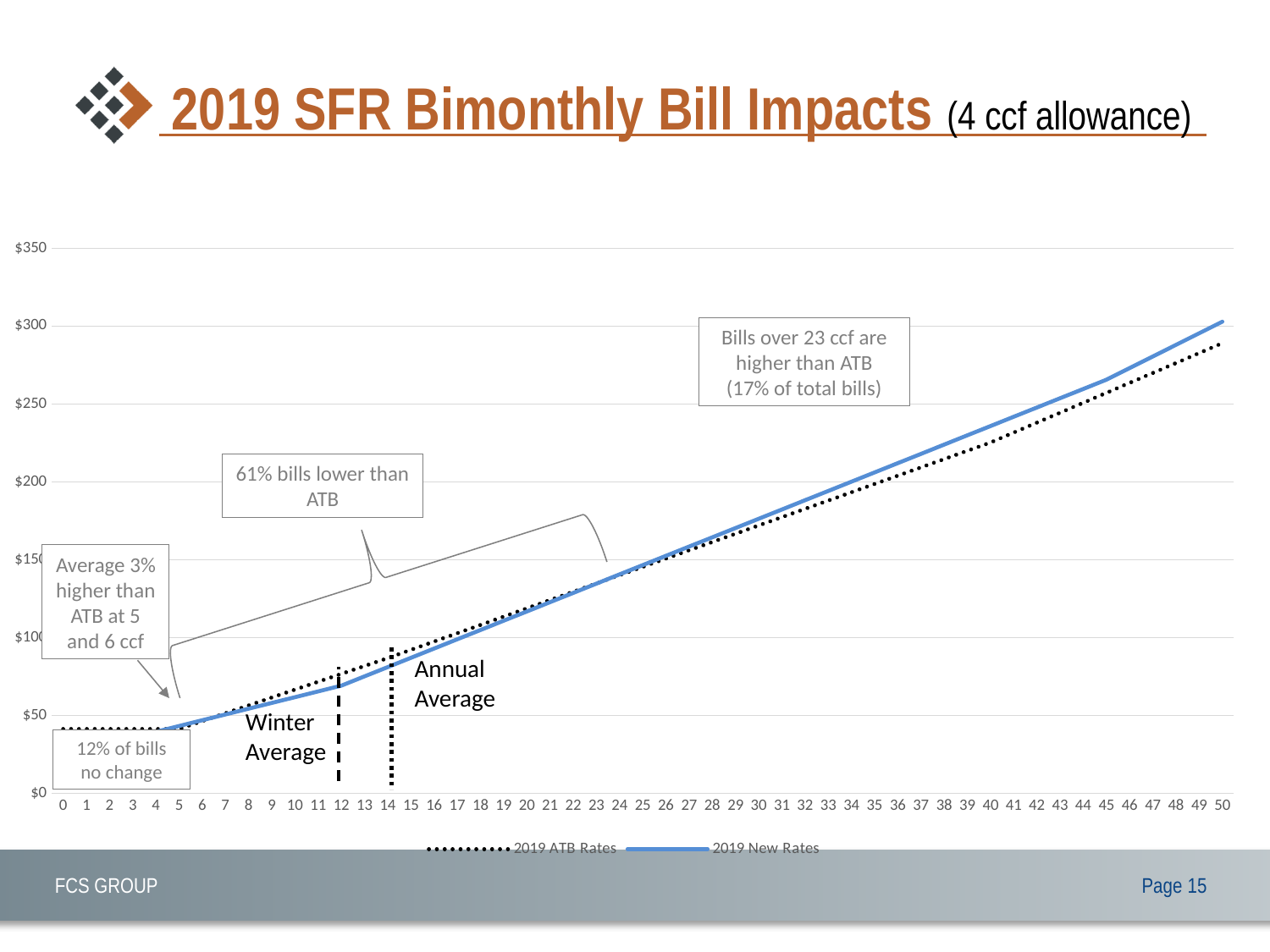
Do the bill values rise or fall as consumption increases along the x axis? Rise At 45 ccf, which series has the higher bill, 2019 ATB Rates or 2019 New Rates? 2019 New Rates Is the 2019 New Rates value at 40 ccf greater or less than $200? greater Is the 2019 ATB Rates value at 50 ccf greater or less than $300? less How many series does the legend list? 2 What is the title of the slide containing the chart? 2019 SFR Bimonthly Bill Impacts (4 ccf allowance) At 10 ccf, which series has the higher bill, 2019 ATB Rates or 2019 New Rates? 2019 ATB Rates What kind of chart is shown on the slide? Line chart What are the two series named in the legend? 2019 ATB Rates and 2019 New Rates Is the 2019 New Rates value at 30 ccf greater or less than $150? greater At which ccf value on the x axis does the 2019 New Rates series reach its highest point? 50